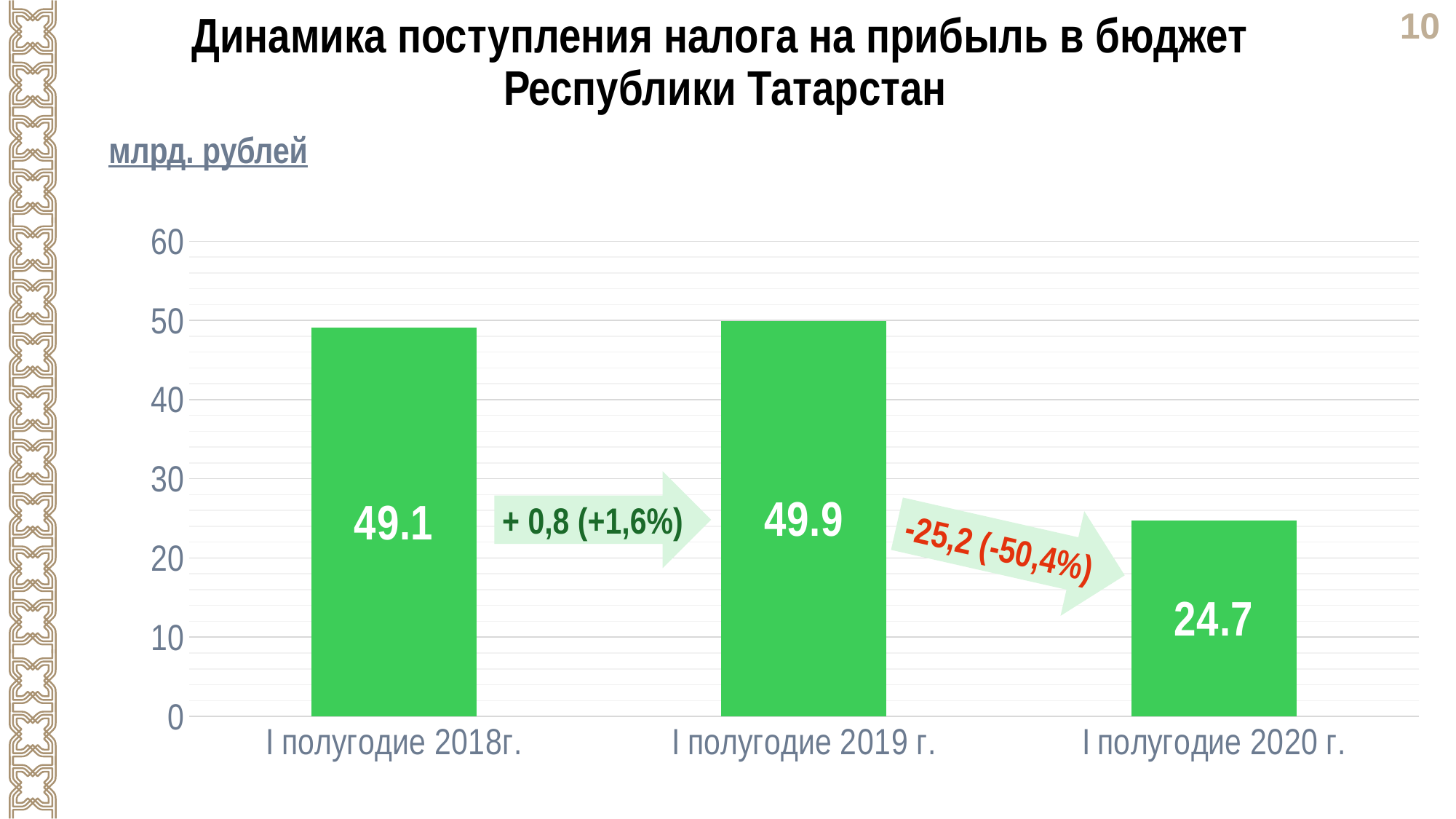
What kind of chart is shown on the slide? bar chart Is the value for I полугодие 2020 г. greater or less than 30? less What is the difference between the values for I полугодие 2019 г. and I полугодие 2018г.? 0.8 What is the value for I полугодие 2020 г.? 24.7 What is the value for I полугодие 2018г.? 49.1 Which period has the lowest value? I полугодие 2020 г. What is the value for I полугодие 2019 г.? 49.9 What unit of measurement is indicated for the chart? млрд. рублей Which is larger, the value for I полугодие 2018г. or I полугодие 2020 г.? I полугодие 2018г. Which period has the highest value? I полугодие 2019 г. How many periods are shown on the chart? 3 What is the difference between the values for I полугодие 2019 г. and I полугодие 2020 г.? 25.2